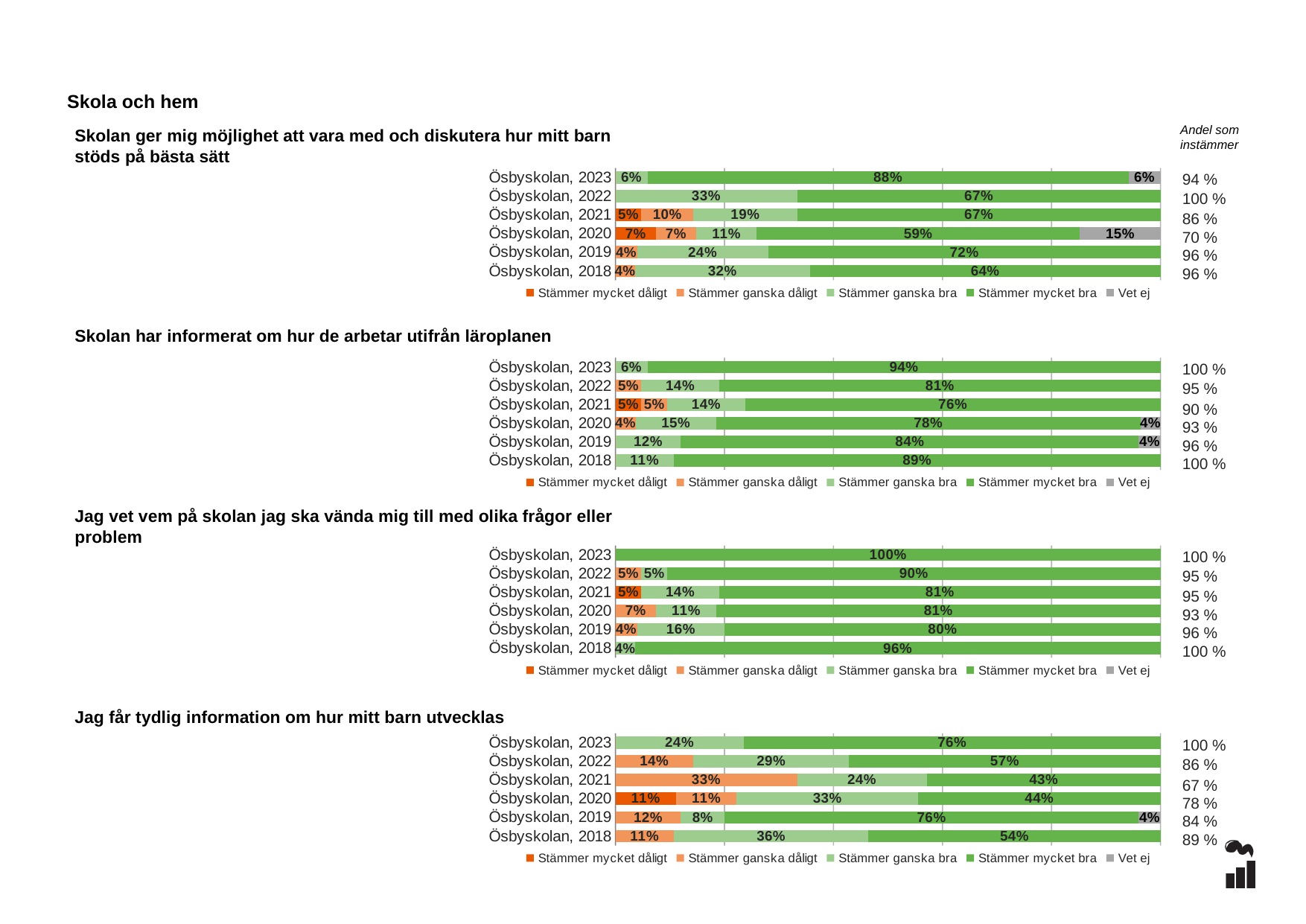
In the chart 'Skolan har informerat om hur de arbetar utifrån läroplanen', what is the difference between the 'Stämmer mycket bra' values for Ösbyskolan, 2018 and Ösbyskolan, 2021? 13% What kind of chart is used for 'Skolan ger mig möjlighet att vara med och diskutera hur mitt barn stöds på bästa sätt'? Stacked bar chart In the chart 'Skolan har informerat om hur de arbetar utifrån läroplanen', which year has the highest 'Stämmer mycket bra' value? Ösbyskolan, 2023 In the chart 'Jag får tydlig information om hur mitt barn utvecklas', which is larger: the 'Stämmer mycket bra' value for Ösbyskolan, 2022 or for Ösbyskolan, 2020? Ösbyskolan, 2022 How many series does the legend list for the chart 'Jag får tydlig information om hur mitt barn utvecklas'? 5 How many bars (years) are shown in the chart 'Skolan har informerat om hur de arbetar utifrån läroplanen'? 6 In the chart 'Jag får tydlig information om hur mitt barn utvecklas', what is the difference between the 'Stämmer ganska bra' values for Ösbyskolan, 2018 and Ösbyskolan, 2023? 12% In the chart 'Skolan ger mig möjlighet att vara med och diskutera hur mitt barn stöds på bästa sätt', what is the 'Vet ej' value for Ösbyskolan, 2020? 15% In the chart 'Jag vet vem på skolan jag ska vända mig till med olika frågor eller problem', what is the 'Stämmer mycket bra' value for Ösbyskolan, 2022? 90% In the chart 'Jag får tydlig information om hur mitt barn utvecklas', what is the 'Stämmer ganska dåligt' value for Ösbyskolan, 2021? 33% In the chart 'Skolan ger mig möjlighet att vara med och diskutera hur mitt barn stöds på bästa sätt', what is the 'Stämmer mycket bra' value for Ösbyskolan, 2023? 88% In the chart 'Jag vet vem på skolan jag ska vända mig till med olika frågor eller problem', which year has the lowest 'Stämmer mycket bra' value? Ösbyskolan, 2019